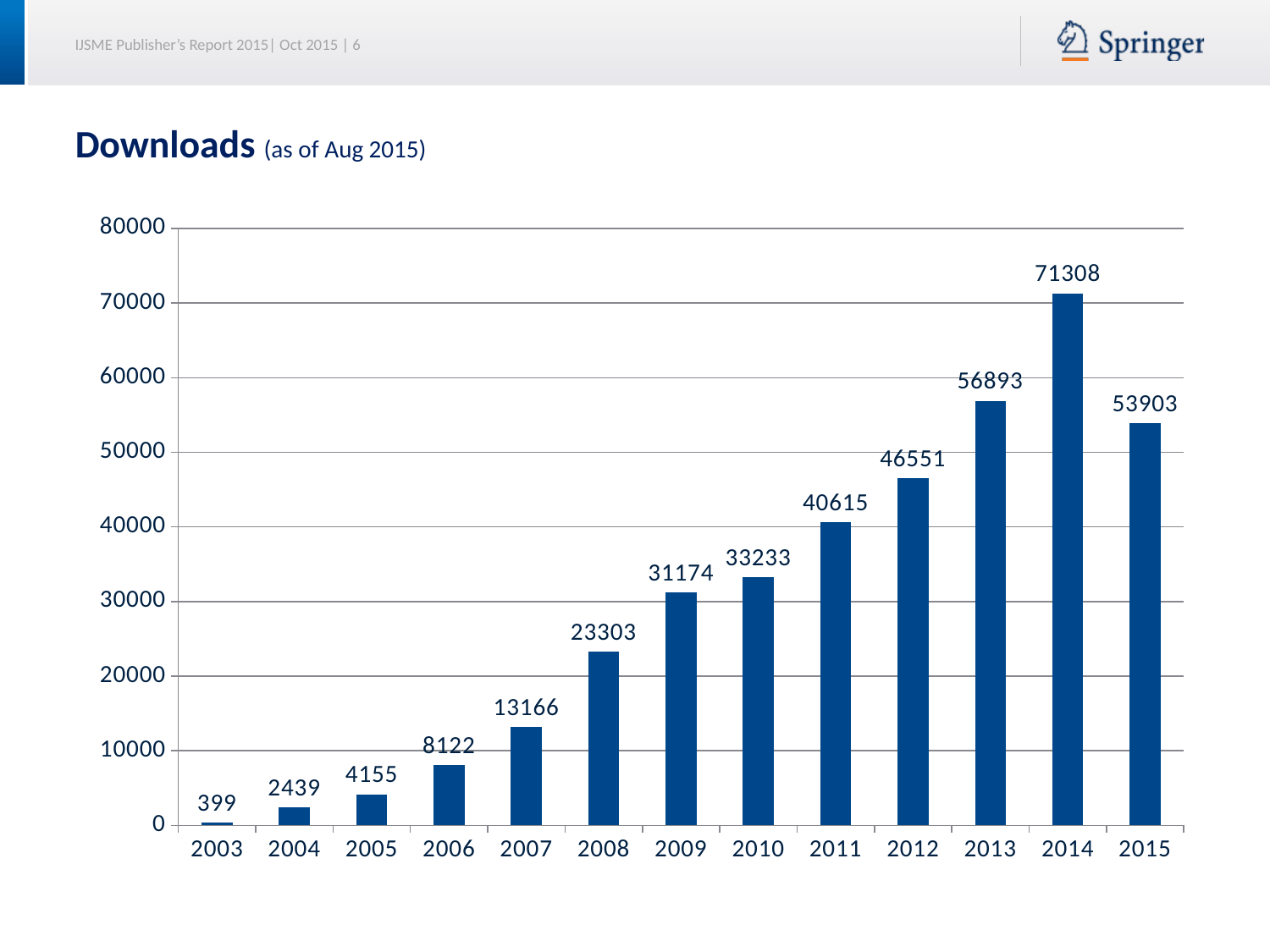
Do downloads rise or fall from 2003 to 2014? Rise What is the difference in downloads between 2009 and 2008? 7871 What kind of chart is shown on the slide? Bar chart Which year has more downloads, 2012 or 2015? 2015 Which year has the lowest number of downloads? 2003 How many years are shown on the x axis? 13 What is the title of the chart? Downloads (as of Aug 2015) Which year has the highest number of downloads? 2014 Is the value for 2011 greater or less than 40000? greater What is the difference in downloads between 2014 and 2013? 14415 What is the number of downloads for 2010? 33233 What is the number of downloads for 2006? 8122